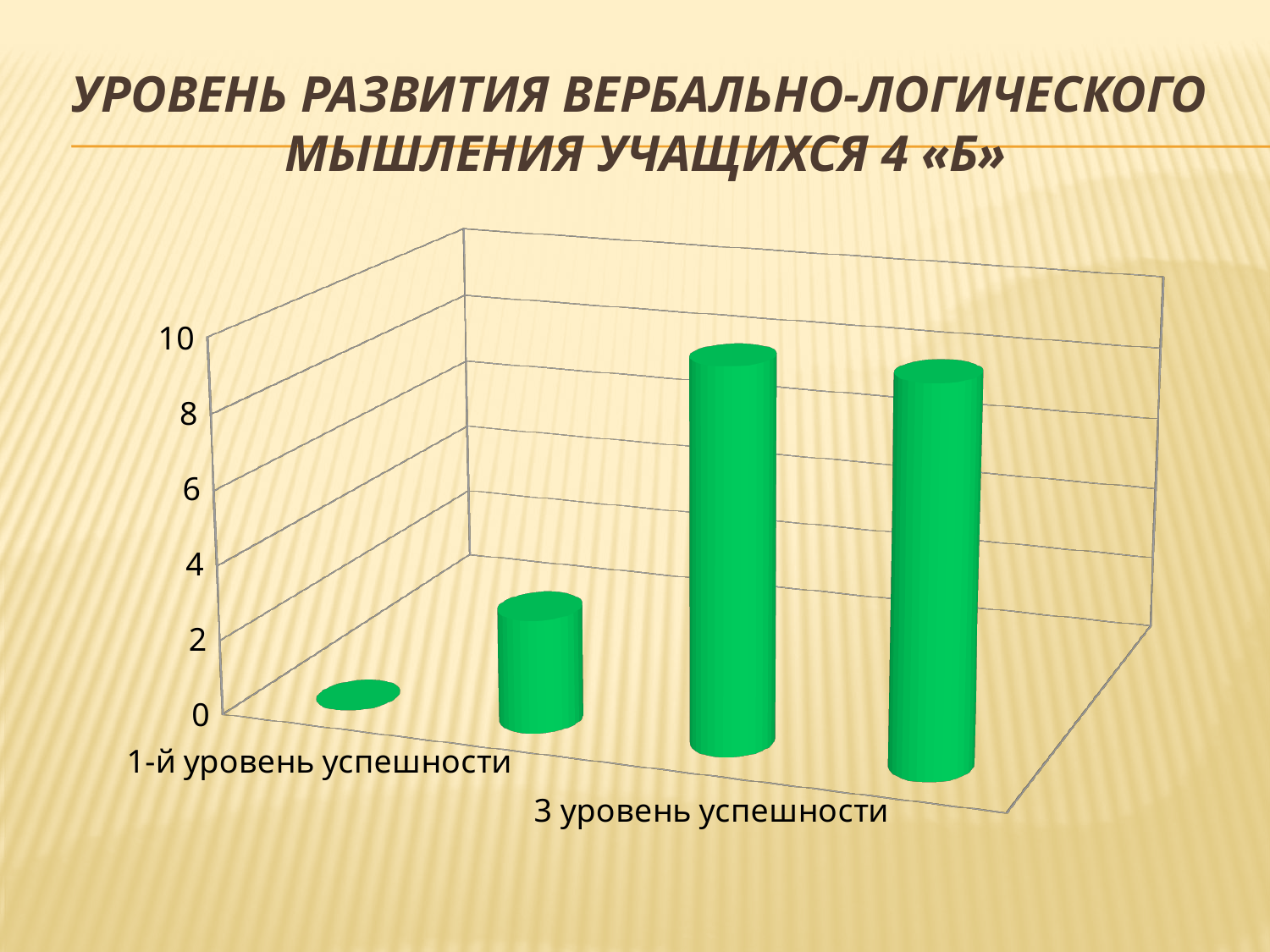
What kind of chart is shown on the slide? bar chart Is the value for 3 уровень успешности greater or less than 6? greater Is the value of the second bar from the left greater or less than 4? less Is the value for 1-й уровень успешности greater or less than 2? less What colour are the bars in the chart? green Which category has the lowest value in the chart? 1-й уровень успешности Which is larger, the value for 1-й уровень успешности or the value for 3 уровень успешности? 3 уровень успешности What is the highest tick value shown on the vertical axis? 10 How many bars are plotted in the chart? 4